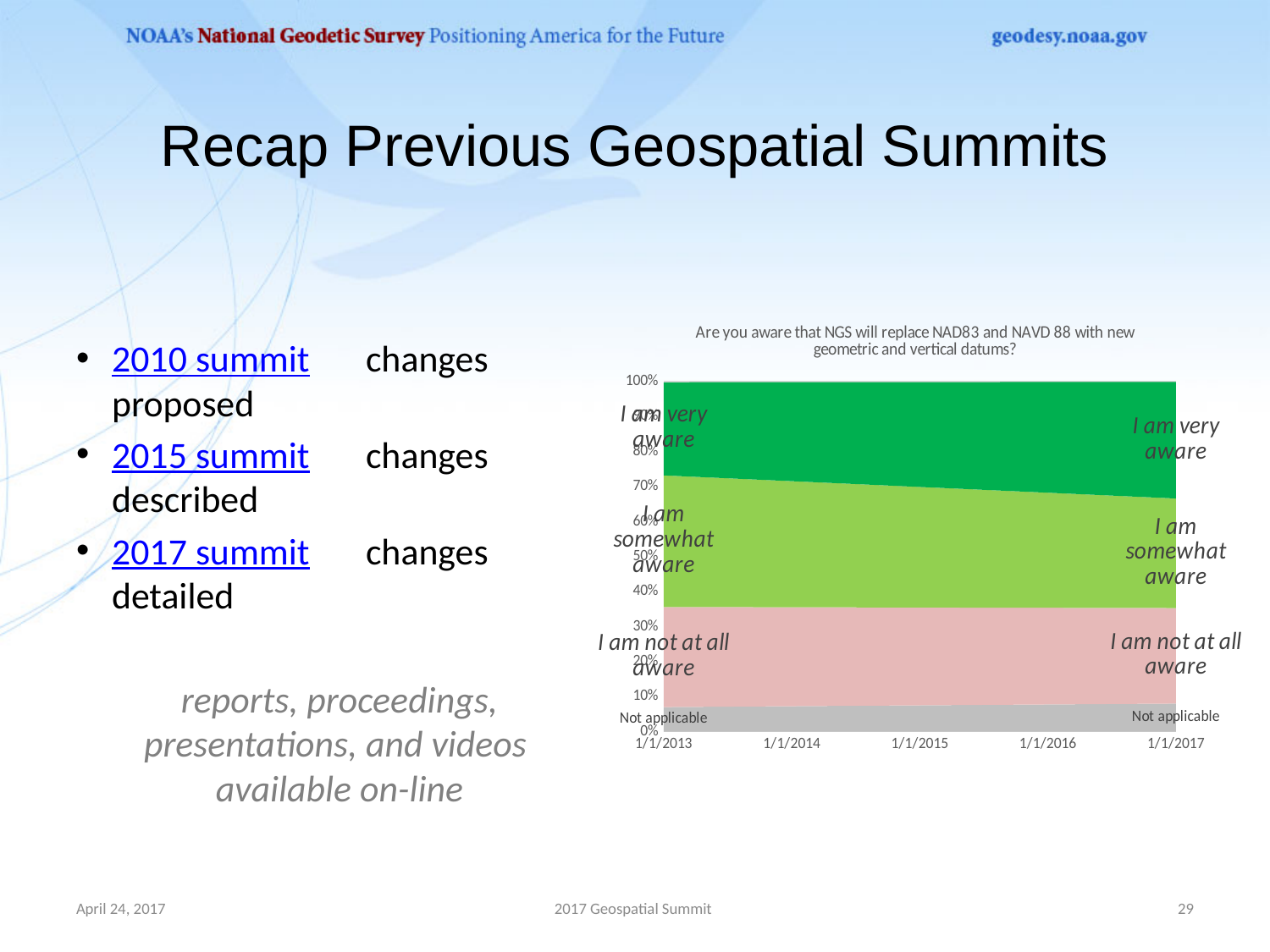
Which response category occupies the top band of the chart? I am very aware Is the share of 'I am very aware' at 1/1/2017 greater or less than 20%? greater What kind of chart is shown on the slide? Stacked area chart Does the share of 'I am very aware' rise or fall from 1/1/2013 to 1/1/2017? Rise How many response categories (series) are labelled on the chart? 4 Does the share of 'I am somewhat aware' rise or fall from 1/1/2013 to 1/1/2017? Fall What is the title of the chart? Are you aware that NGS will replace NAD83 and NAVD 88 with new geometric and vertical datums? What is the first date shown on the x axis of the chart? 1/1/2013 Is the share of 'I am very aware' at 1/1/2013 greater or less than 30%? less Which response category occupies the bottom band of the chart? Not applicable How many dates are marked along the x axis of the chart? 5 Is the share of 'Not applicable' at 1/1/2013 greater or less than 10%? less